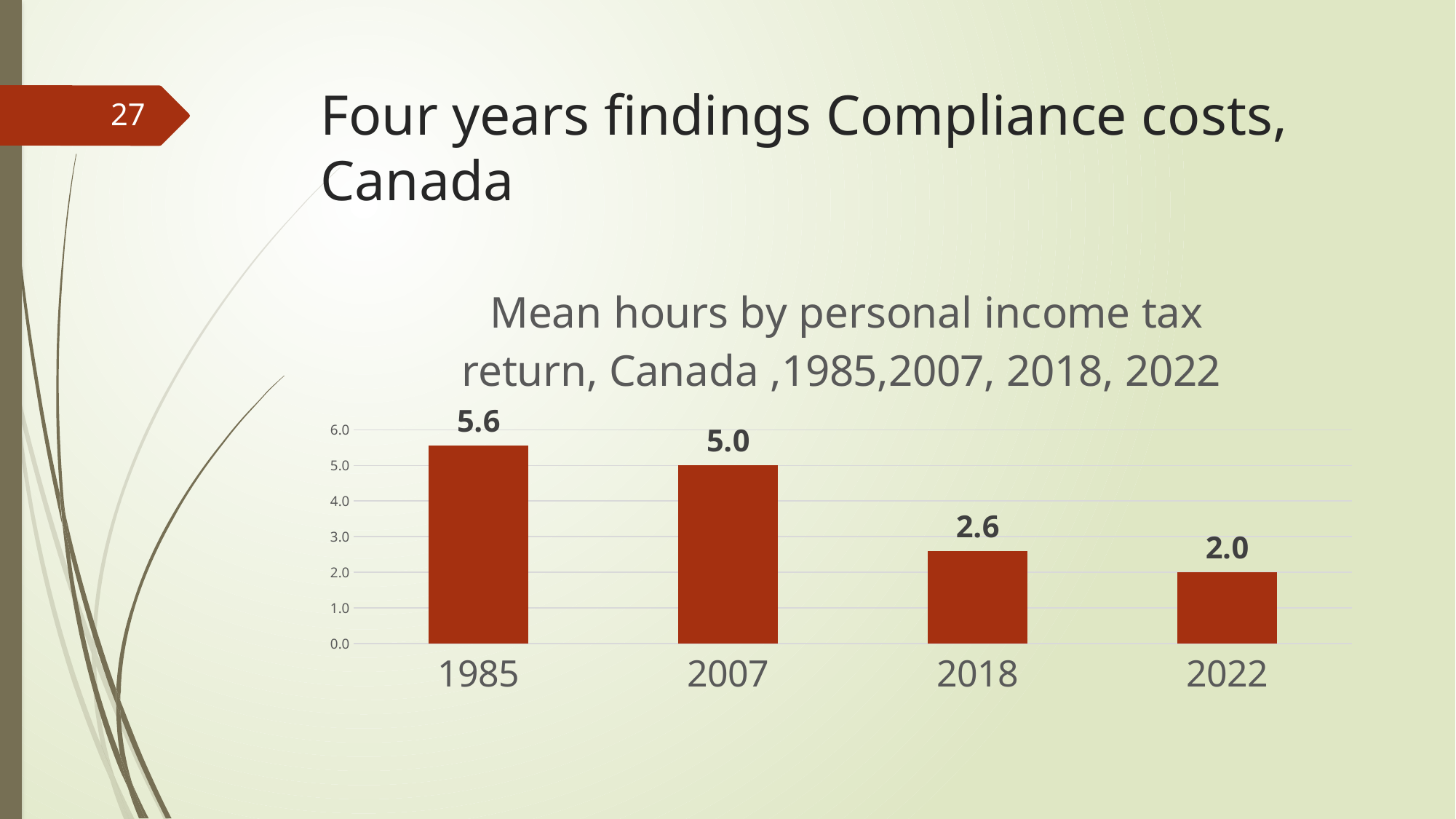
What kind of chart is shown on the slide? Bar chart Which year has the highest mean hours? 1985 Do the values rise or fall from 1985 to 2022? Fall What is the mean hours value for 2007? 5.0 What is the difference in mean hours between 1985 and 2022? 3.6 What is the difference in mean hours between 2007 and 2018? 2.4 What is the mean hours value for 2022? 2.0 Which year has a larger value, 2007 or 2018? 2007 What is the mean hours value for 2018? 2.6 How many years are shown on the chart? 4 What is the mean hours value for 1985? 5.6 Which year has the lowest mean hours? 2022